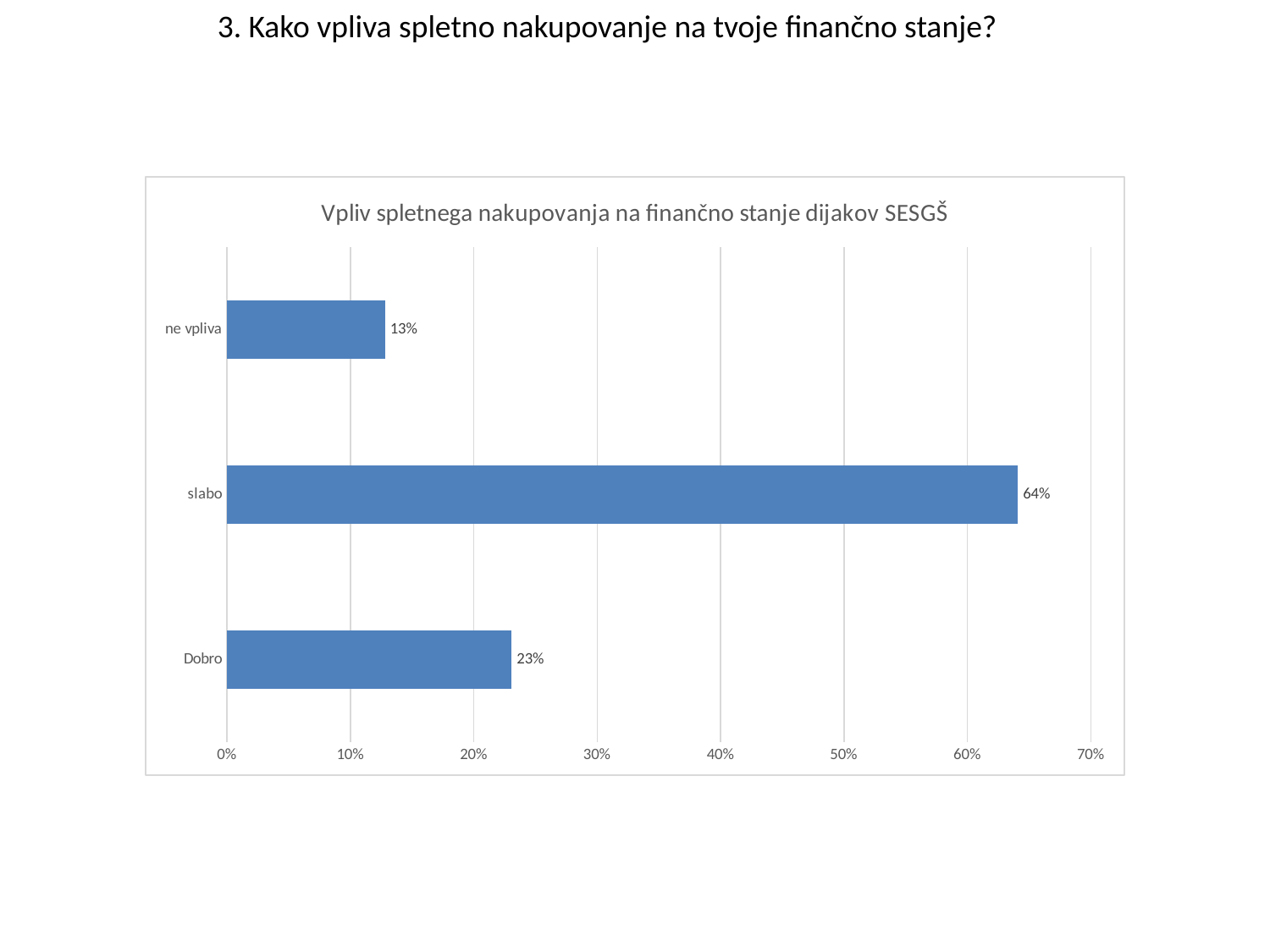
Is the value for "slabo" greater or less than 50%? greater What is the difference between the values for "slabo" and "Dobro"? 41% What is the value for "ne vpliva"? 13% Which is larger, the value for "Dobro" or the value for "ne vpliva"? Dobro What is the value for "slabo"? 64% How many categories are shown in the chart? 3 What is the value for "Dobro"? 23% What kind of chart is shown on the slide? bar chart Which category has the lowest value? ne vpliva What is the difference between the values for "Dobro" and "ne vpliva"? 10% Which category has the highest value? slabo What is the title of the chart? Vpliv spletnega nakupovanja na finančno stanje dijakov SESGŠ